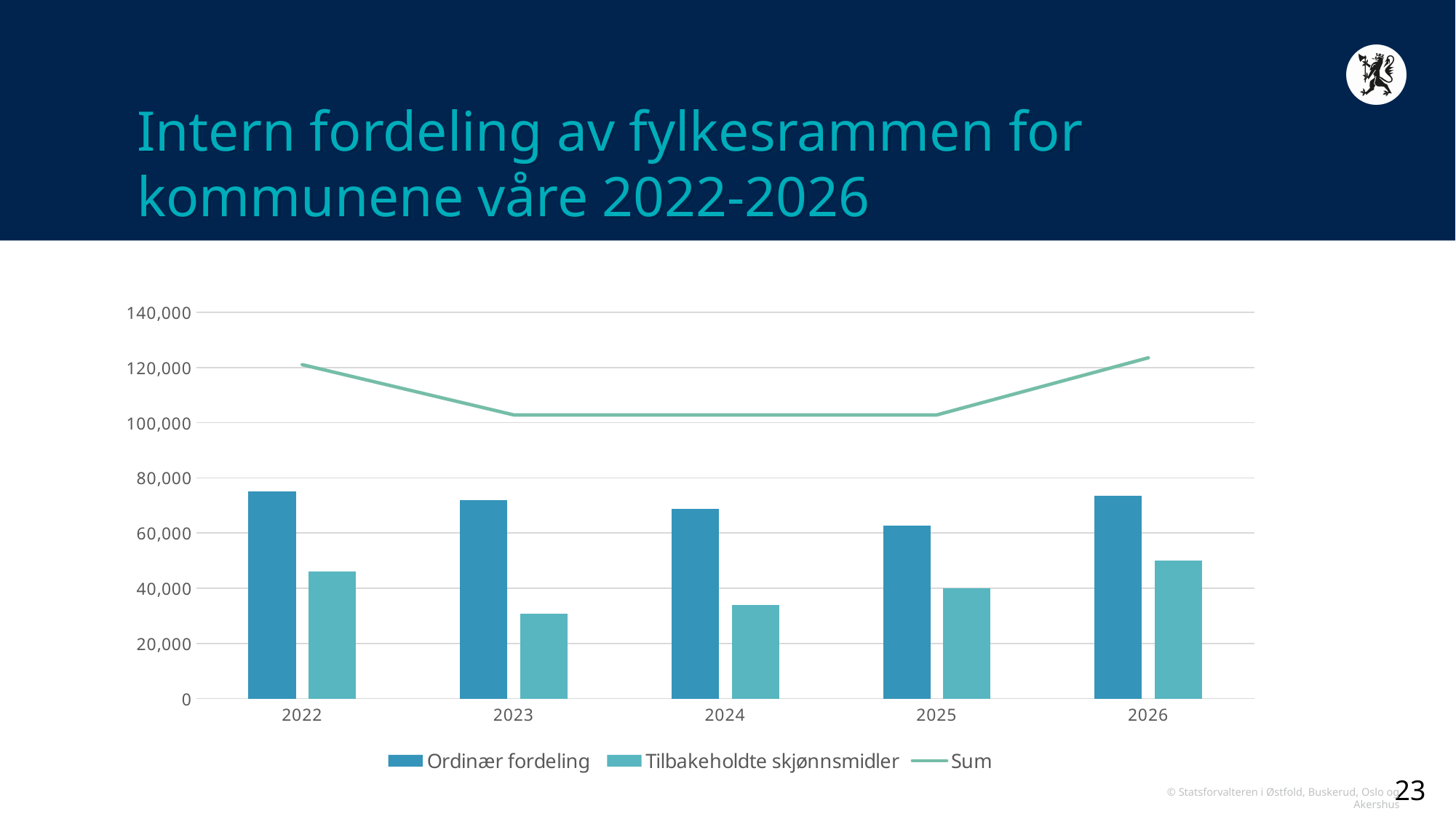
How many years are shown on the x axis of the chart? 5 Is the value for Ordinær fordeling in 2025 greater or less than 80,000? less In which year is the Ordinær fordeling bar lowest? 2025 Is the Sum value for 2023 greater or less than 100,000? greater In which year is the Tilbakeholdte skjønnsmidler bar lowest? 2023 In which year is the Tilbakeholdte skjønnsmidler bar highest? 2026 Which series is drawn as a line in the chart? Sum How many series does the chart legend list? 3 What kind of chart is shown on the slide? A combined bar and line chart Does the Ordinær fordeling series rise or fall from 2022 to 2025? Fall In 2022, which is larger: Ordinær fordeling or Tilbakeholdte skjønnsmidler? Ordinær fordeling Is the value for Tilbakeholdte skjønnsmidler in 2022 greater or less than 40,000? greater